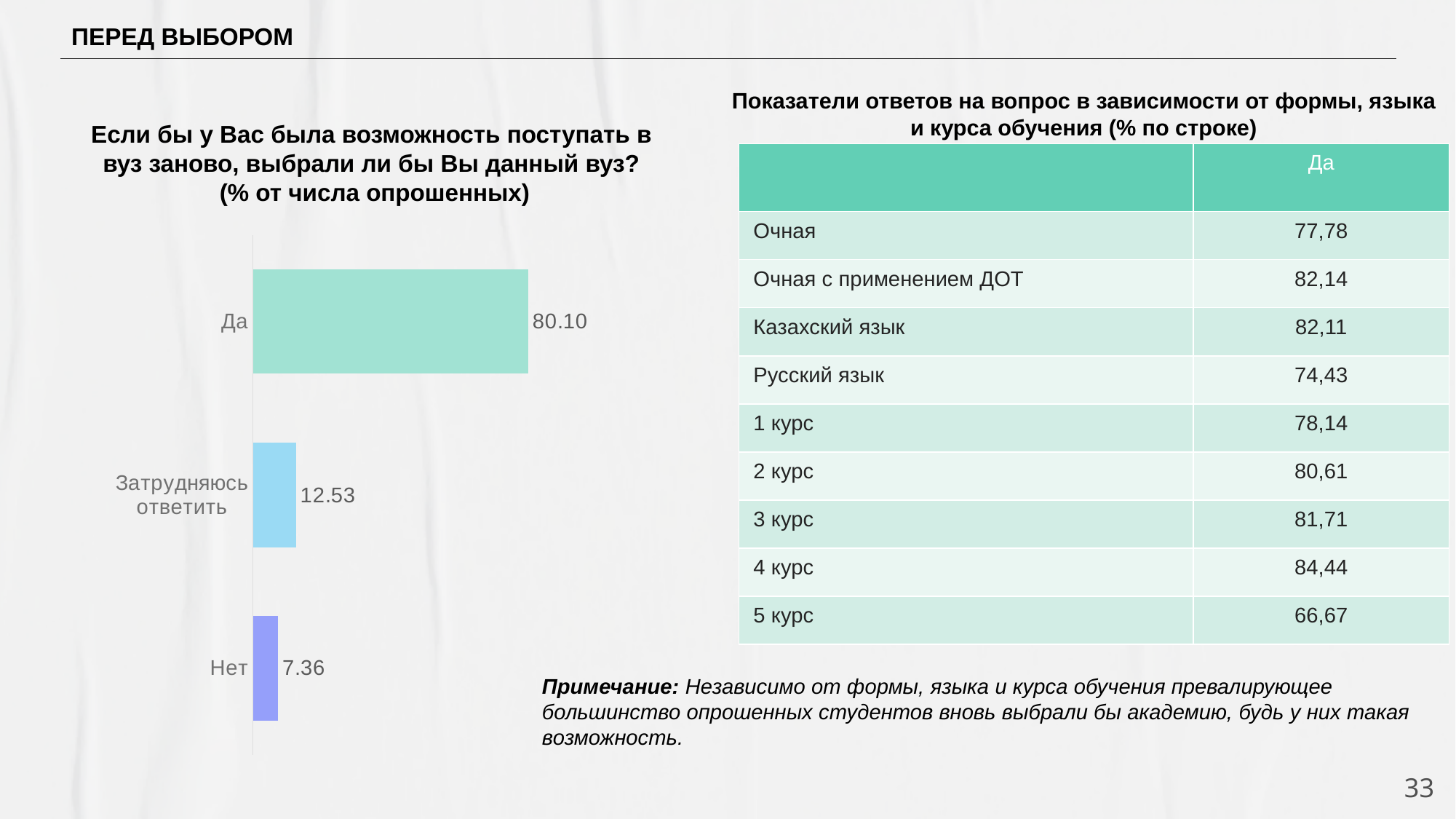
What colour is the bar for "Нет" in the bar chart? Purple What type of chart is shown on the slide? Bar chart What is the value for "Нет" in the bar chart? 7.36 What is the title of the bar chart? Если бы у Вас была возможность поступать в вуз заново, выбрали ли бы Вы данный вуз? (% от числа опрошенных) How many categories are shown in the bar chart? 3 What is the difference between the values for "Да" and "Нет" in the bar chart? 72.74 What is the value for "Затрудняюсь ответить" in the bar chart? 12.53 What is the difference between the values for "Затрудняюсь ответить" and "Нет" in the bar chart? 5.17 Which category has the lowest value in the bar chart? Нет Which category has the highest value in the bar chart? Да Which is larger in the bar chart: the value for "Затрудняюсь ответить" or the value for "Нет"? Затрудняюсь ответить What is the value for "Да" in the bar chart? 80.10